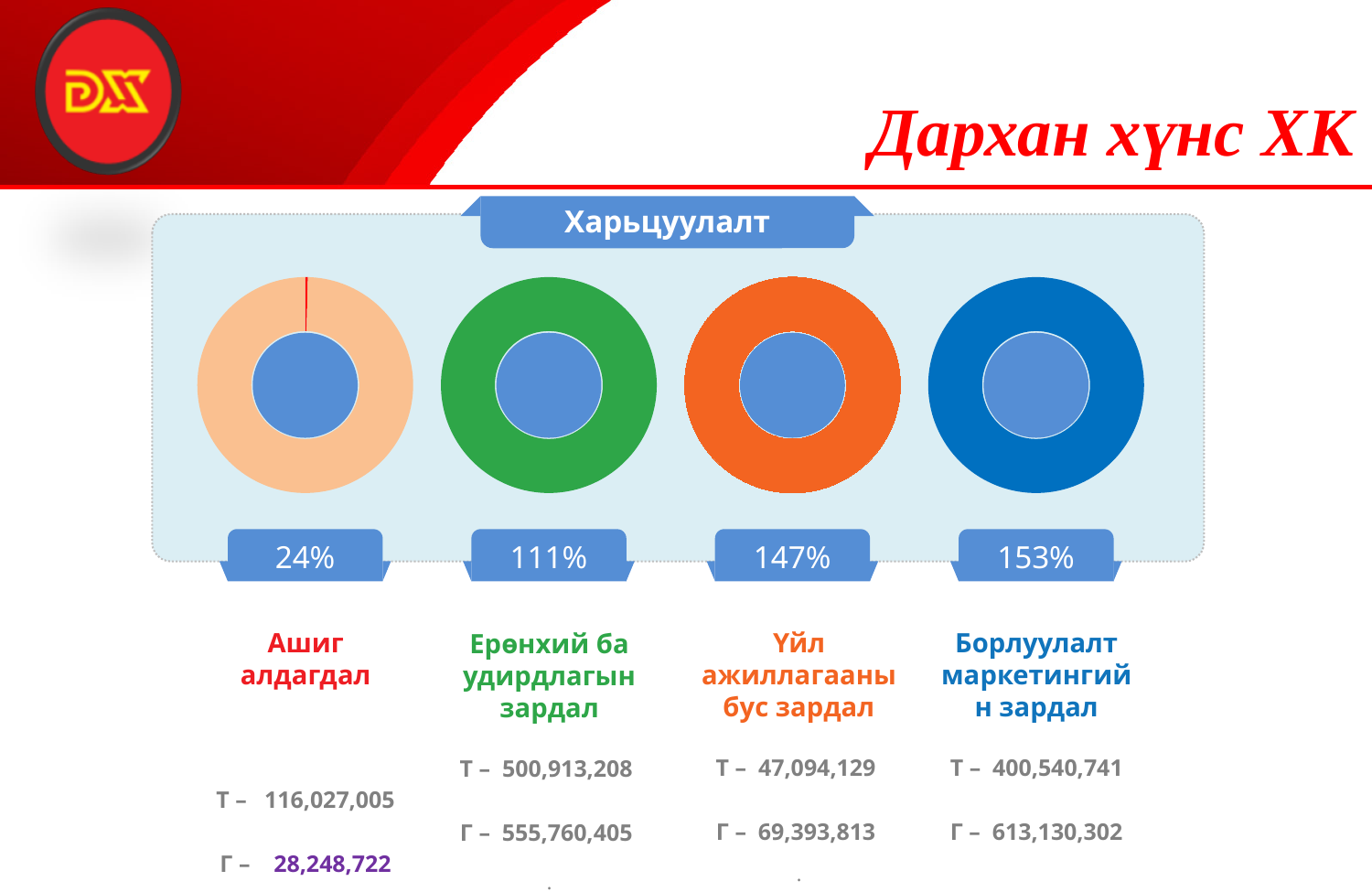
What is the 'Г' value listed for 'Ашиг алдагдал'? 28,248,722 What is the 'Т' value listed for 'Борлуулалт маркетингийн зардал'? 400,540,741 Which category has the lowest percentage shown? Ашиг алдагдал What percentage is shown under the 'Үйл ажиллагааны бус зардал' circle? 147% What percentage is shown under the 'Ашиг алдагдал' circle? 24% Which category has the highest percentage shown? Борлуулалт маркетингийн зардал Which has a higher percentage: 'Ерөнхий ба удирдлагын зардал' or 'Үйл ажиллагааны бус зардал'? Үйл ажиллагааны бус зардал What percentage is shown under the 'Борлуулалт маркетингийн зардал' circle? 153% What is the difference between the percentages for 'Борлуулалт маркетингийн зардал' and 'Ашиг алдагдал'? 129% What is the title shown above the circles? Харьцуулалт How many circles (categories) are shown in the comparison? 4 What percentage is shown under the 'Ерөнхий ба удирдлагын зардал' circle? 111%